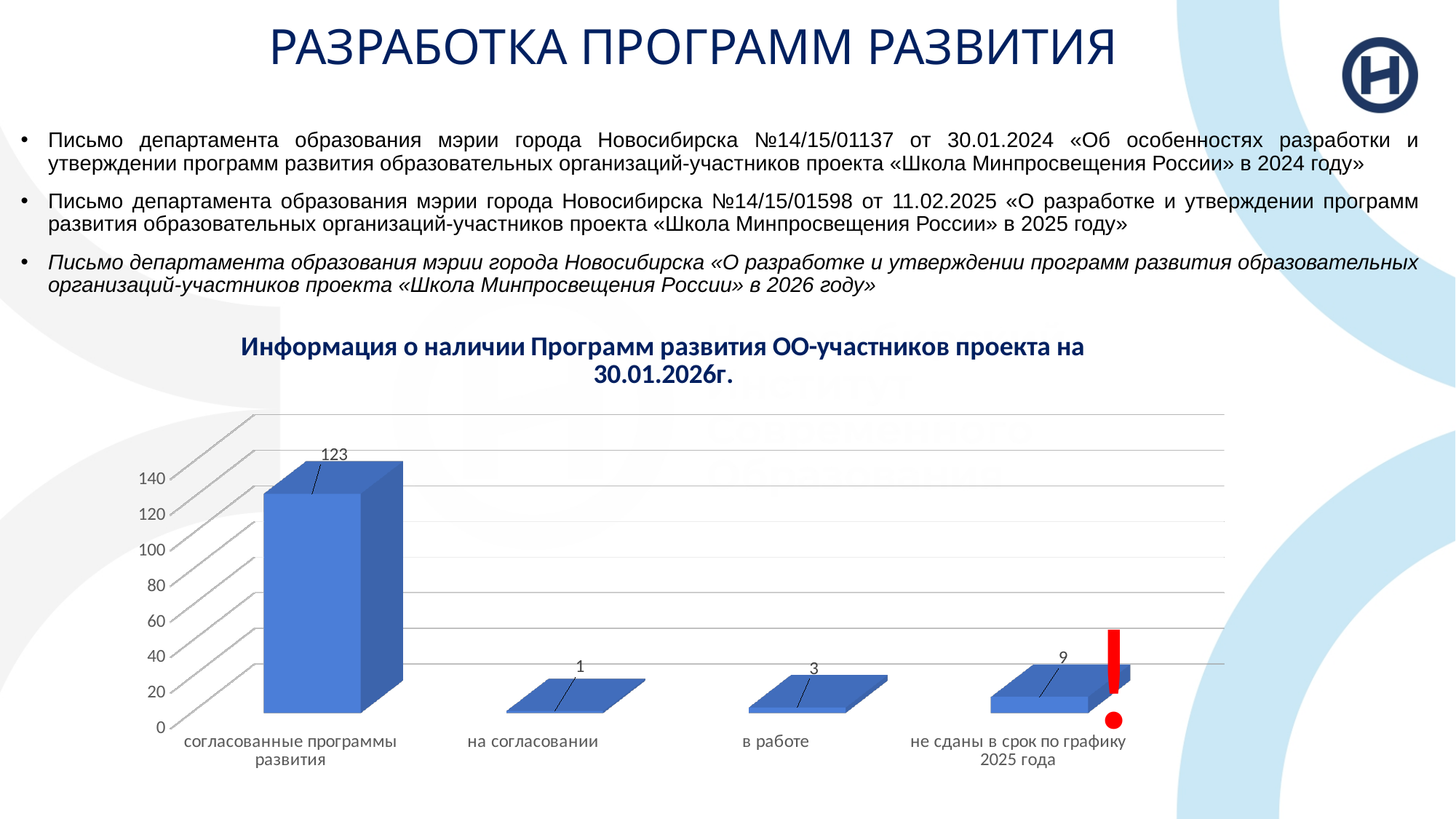
What is the value for «на согласовании»? 1 What is the value for «в работе»? 3 What kind of chart is shown on the slide? bar chart Which is larger: the value for «в работе» or the value for «не сданы в срок по графику 2025 года»? не сданы в срок по графику 2025 года What is the value for «согласованные программы развития»? 123 Is the value for «согласованные программы развития» greater or less than 100? greater How many categories are shown on the chart? 4 Which category has the lowest value? на согласовании What is the value for «не сданы в срок по графику 2025 года»? 9 What is the title of the chart? Информация о наличии Программ развития ОО-участников проекта на 30.01.2026г. What is the difference between the values for «согласованные программы развития» and «не сданы в срок по графику 2025 года»? 114 Which category has the highest value? согласованные программы развития